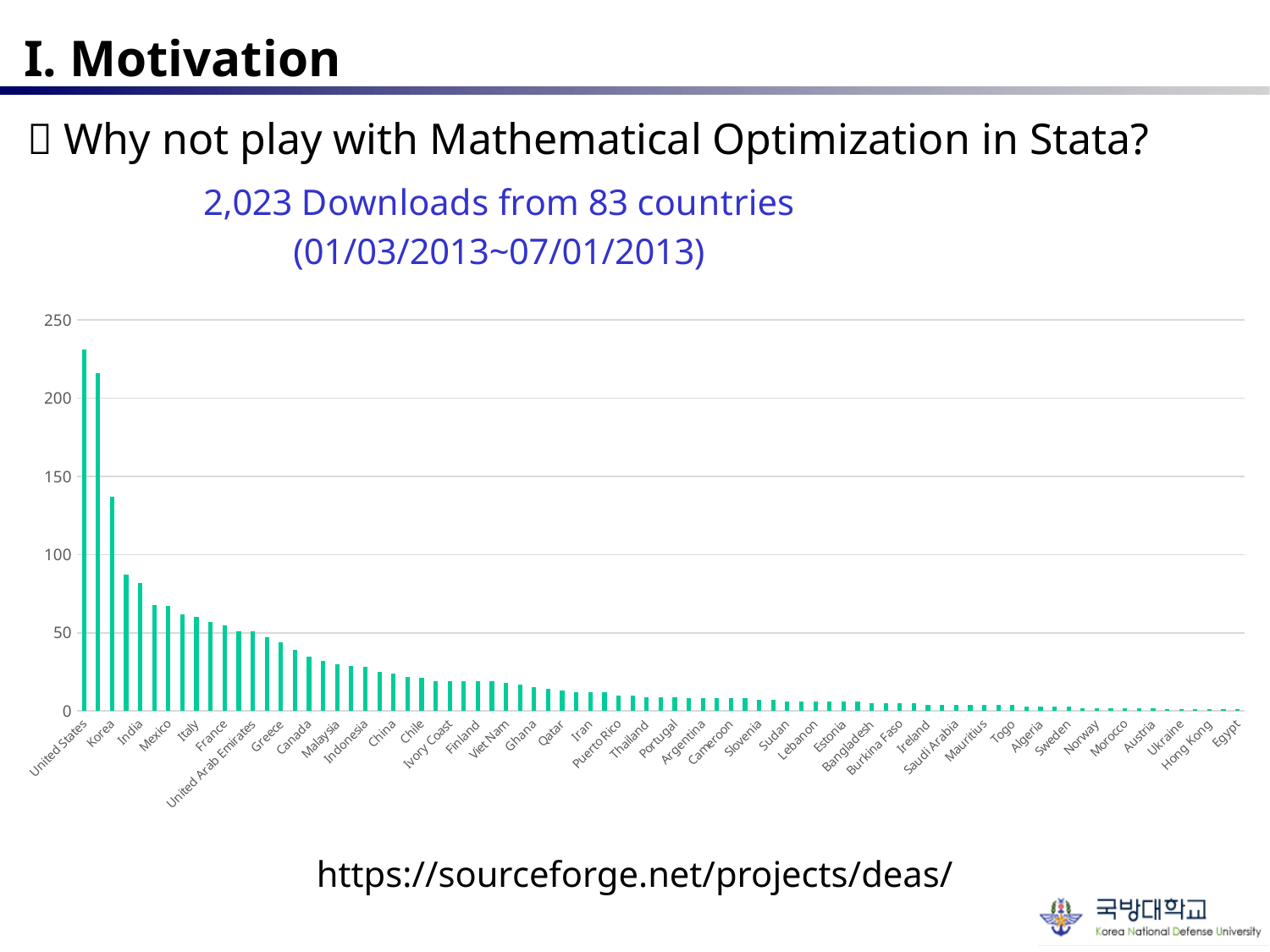
Is the value for Canada greater or less than 50? less Is the value for Korea greater or less than 150? less Which has more downloads, United States or Korea? United States Is the value for United States greater or less than 200? greater According to the text above the chart, how many countries did the 2,023 downloads come from? 83 Do the values rise or fall moving from left to right along the x axis? fall Which has more downloads, India or Mexico? India Which country has the highest number of downloads in the chart? United States What kind of chart is shown on the slide? bar chart